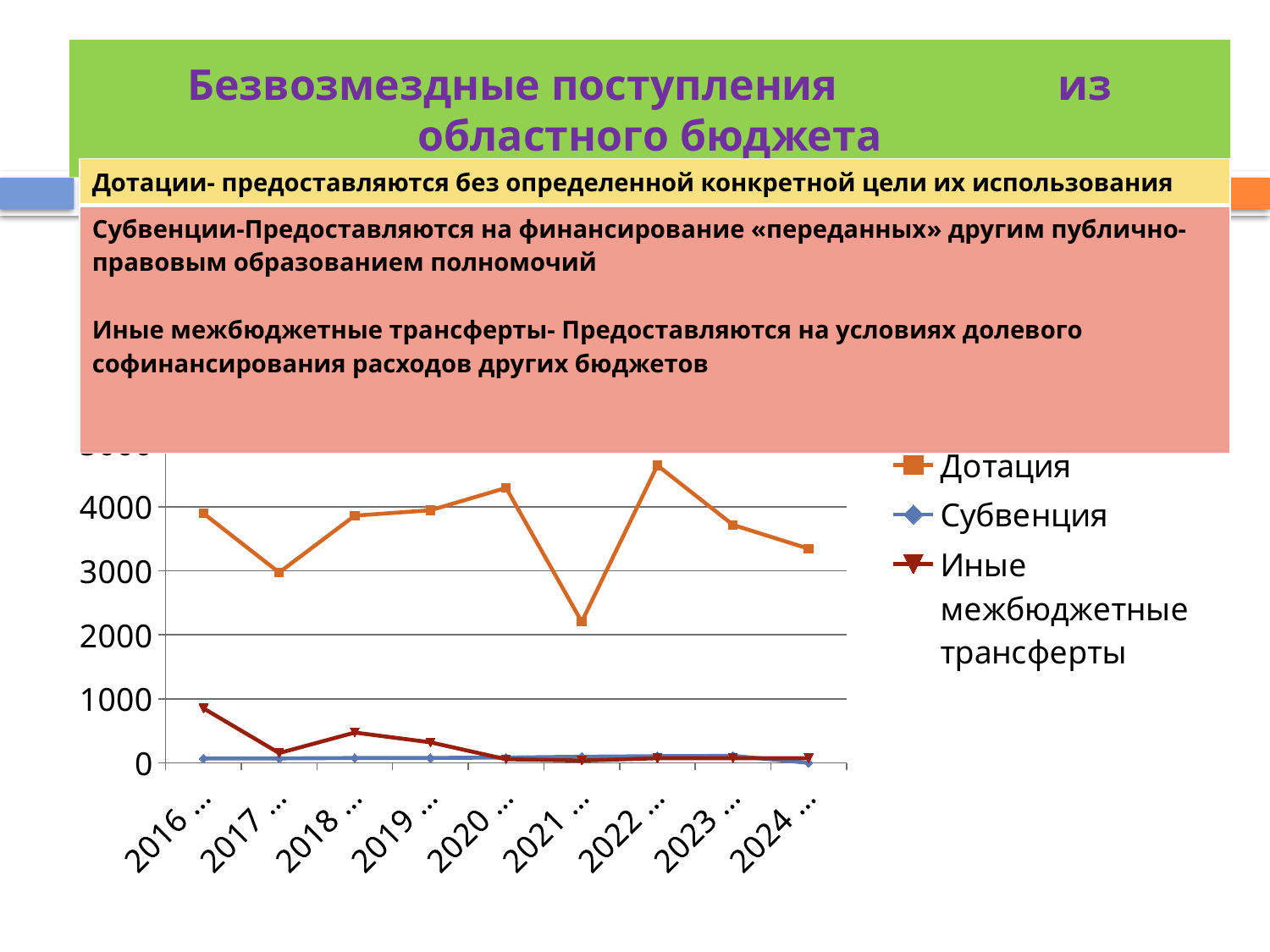
Does the value for Иные межбюджетные трансферты rise or fall from 2016 to 2017? fall How many years are plotted along the x axis? 9 Is the value for Дотация in 2021 greater or less than 3000? less In which year is the value for Дотация highest? 2022 Is the value for Дотация in 2022 greater or less than 4000? greater In which year is the value for Дотация lowest? 2021 Is the value for Иные межбюджетные трансферты in 2016 greater or less than 1000? less In which year is the value for Иные межбюджетные трансферты highest? 2016 How many series does the legend list? 3 Which series is drawn in orange in the legend? Дотация Which is larger, the value for Дотация in 2016 or in 2017? 2016 What kind of chart is shown on the slide? line chart